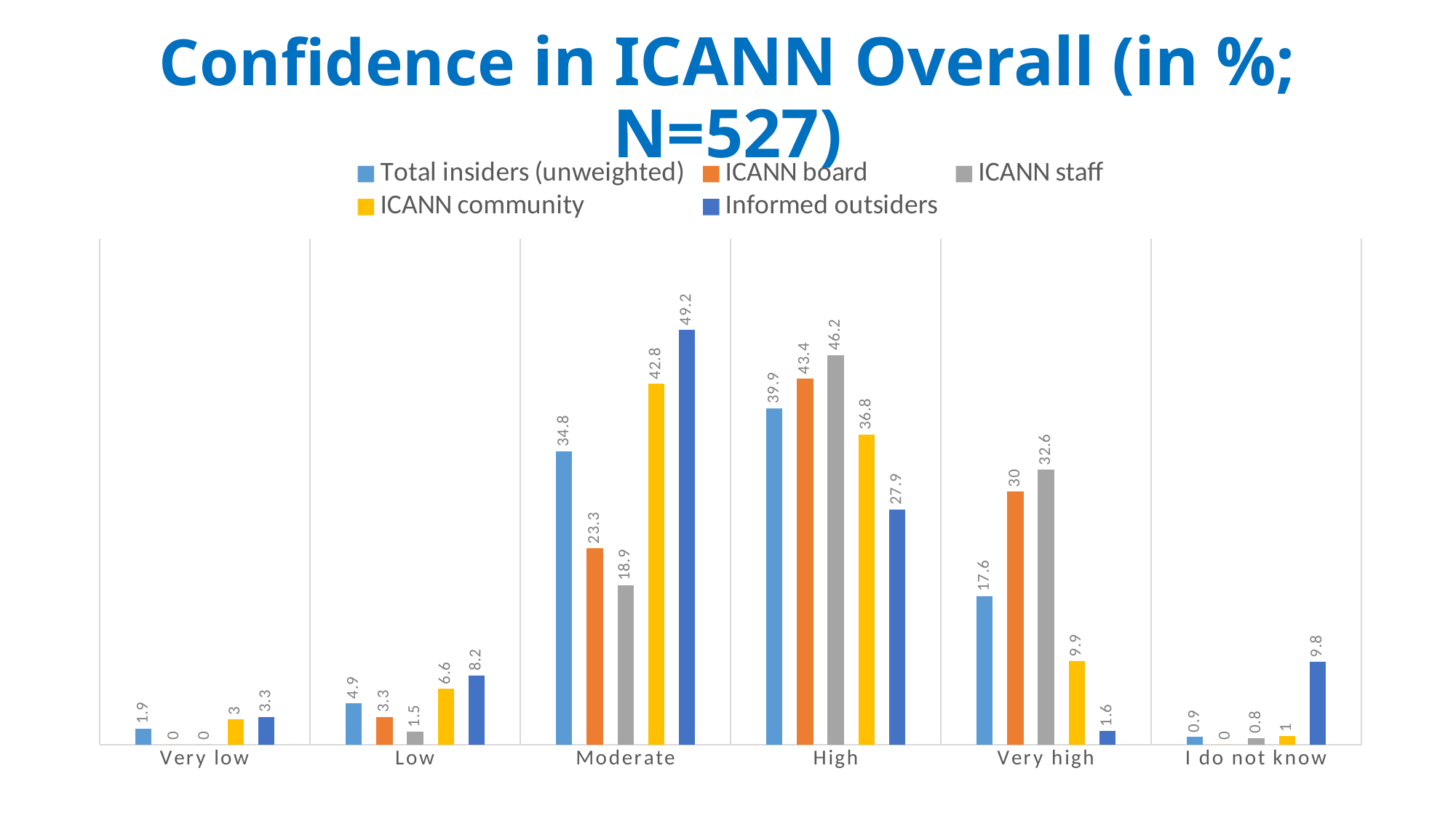
What is the value for Total insiders (unweighted) in the Low category? 4.9 What is the value for Informed outsiders in the Moderate category? 49.2 What kind of chart is shown on the slide? Bar chart What is the title of the chart? Confidence in ICANN Overall (in %; N=527) What is the value for ICANN staff in the High category? 46.2 How many series does the legend list? 5 Which series has the lowest value in the Very high category? Informed outsiders Which is larger in the High category: ICANN board or ICANN community? ICANN board How many categories are shown on the x axis? 6 Which category has the highest value for Informed outsiders? Moderate What is the value for ICANN community in the Very high category? 9.9 What is the difference between ICANN staff and ICANN board in the Very high category? 2.6